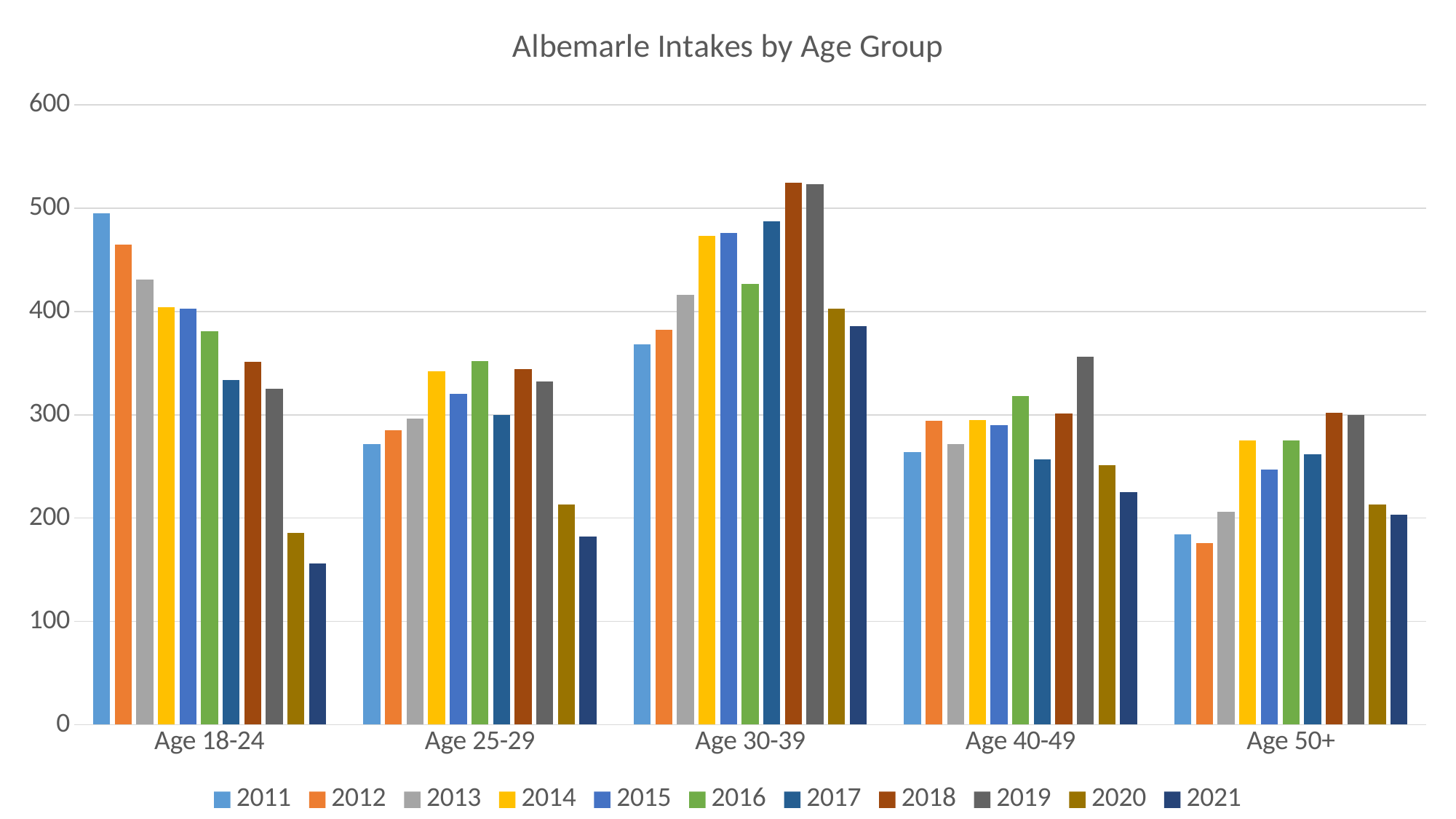
How many age groups are shown on the x axis? 5 What is the title of the chart? Albemarle Intakes by Age Group Is the value for 2021 in the Age 18-24 group greater or less than 200? less Is the value for 2011 in the Age 18-24 group greater or less than 400? greater What kind of chart is shown on the slide? Bar chart Is the value for 2019 in the Age 40-49 group greater or less than 300? greater In the Age 30-39 group, which is larger, the 2017 bar or the 2016 bar? 2017 Within the Age 40-49 group, which year has the highest bar? 2019 Which age group has the highest 2018 bar? Age 30-39 Within the Age 18-24 group, which year has the lowest bar? 2021 Within the Age 18-24 group, do the bars generally rise or fall from 2011 to 2021? fall How many series does the legend list? 11